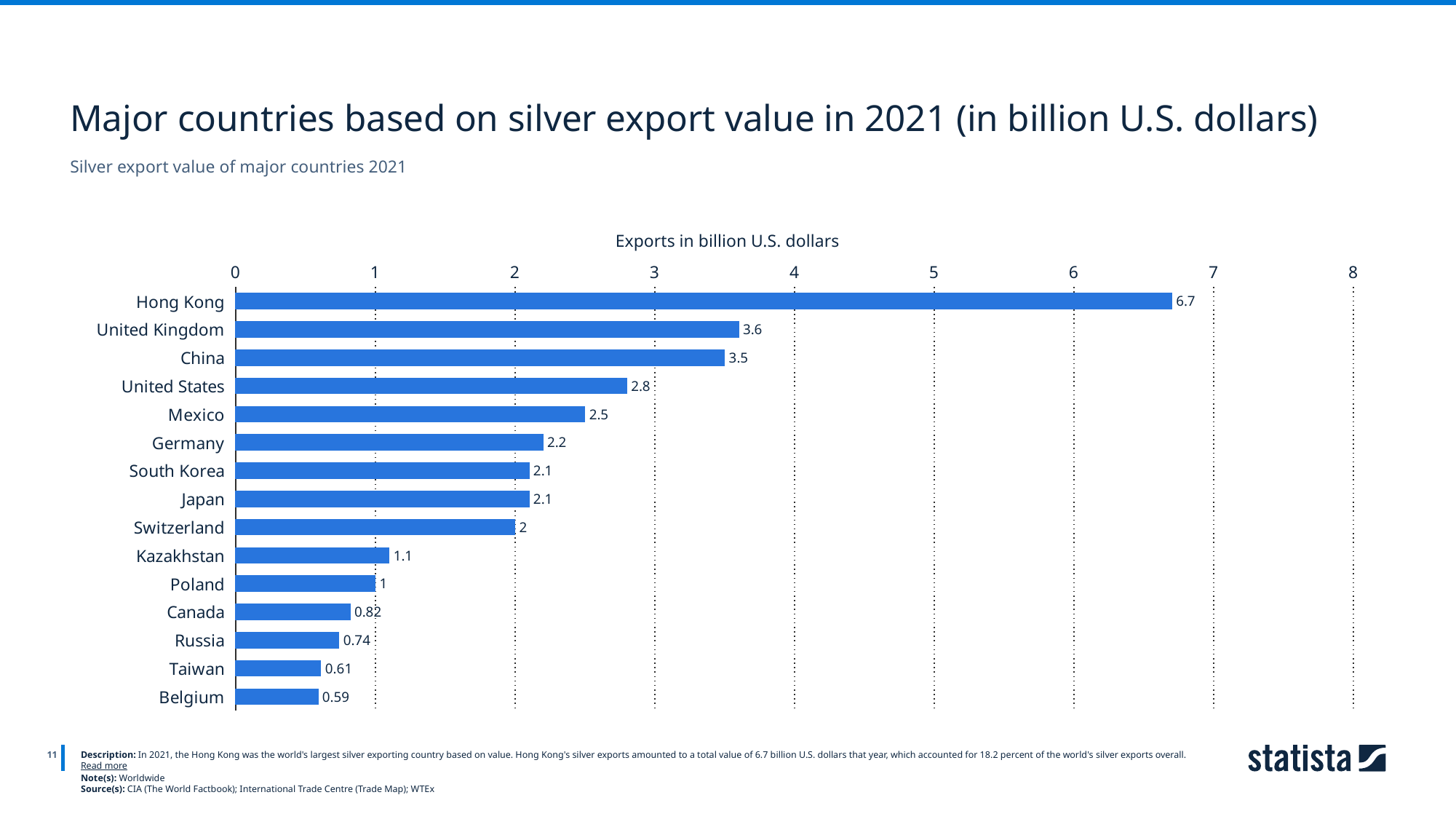
What is the difference between the silver export values of Hong Kong and the United Kingdom? 3.1 Which country has the lowest silver export value? Belgium What is the silver export value for Mexico? 2.5 Which has a larger silver export value, the United States or Germany? United States Which country has the highest silver export value? Hong Kong Is the value for Kazakhstan greater or less than 1? greater What kind of chart is shown on the slide? Bar chart What is the difference between the silver export values of Russia and Taiwan? 0.13 How many countries are shown in the chart? 15 What is the silver export value for Hong Kong? 6.7 What is the axis title shown above the chart? Exports in billion U.S. dollars What is the silver export value for Canada? 0.82